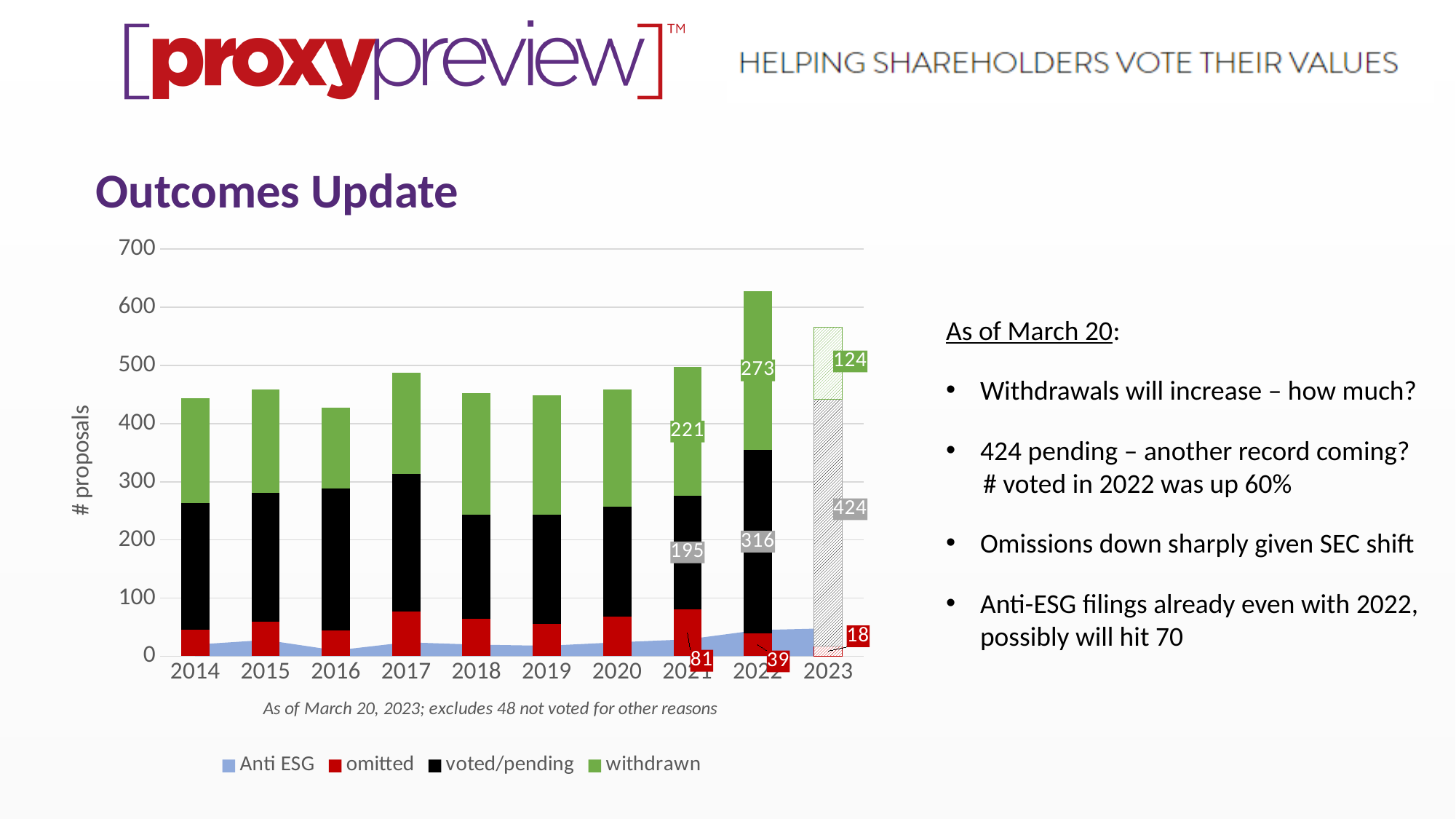
What is the sum of the omitted, voted/pending and withdrawn segments for 2022? 628 What is the difference between the omitted values for 2021 and 2022? 42 Is the total height of the 2016 bar greater or less than 500? less What is the withdrawn value for 2023? 124 How many withdrawn proposals are shown for 2022? 273 How many series does the legend list? 4 By how much did voted/pending increase from 2021 to 2022? 121 Which year has the larger withdrawn value, 2021 or 2022? 2022 How many omitted proposals are labelled for 2021? 81 What is the voted/pending value for 2023? 424 How many years are shown on the x axis? 10 Which year has the tallest stacked bar? 2022